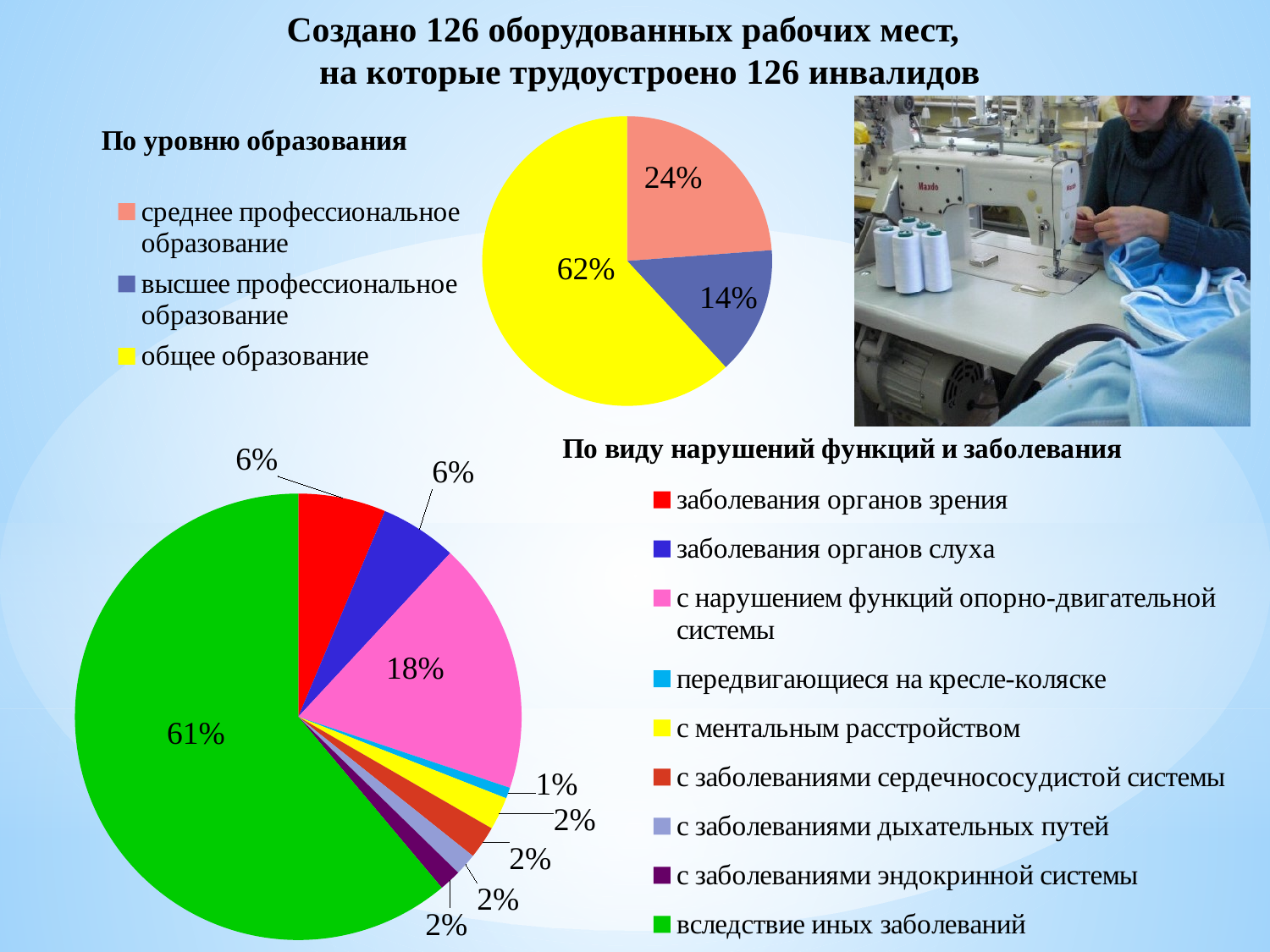
What type of chart is used for 'По виду нарушений функций и заболевания'? pie chart On the chart 'По уровню образования', what share is shown for 'общее образование'? 62% On the chart 'По виду нарушений функций и заболевания', how many categories does the legend list? 9 On the chart 'По виду нарушений функций и заболевания', which is larger: the share for 'заболевания органов зрения' or the share for 'с нарушением функций опорно-двигательной системы'? с нарушением функций опорно-двигательной системы On the chart 'По уровню образования', how many categories does the legend list? 3 On the chart 'По уровню образования', what is the difference between the shares for 'среднее профессиональное образование' and 'высшее профессиональное образование'? 10% On the chart 'По уровню образования', what share is shown for 'высшее профессиональное образование'? 14% On the chart 'По уровню образования', which category has the largest slice? общее образование On the chart 'По виду нарушений функций и заболевания', what share is shown for 'с нарушением функций опорно-двигательной системы'? 18% On the chart 'По виду нарушений функций и заболевания', what colour represents 'с ментальным расстройством'? yellow On the chart 'По виду нарушений функций и заболевания', which category has the smallest slice? передвигающиеся на кресле-коляске On the chart 'По виду нарушений функций и заболевания', what share is shown for 'вследствие иных заболеваний'? 61%